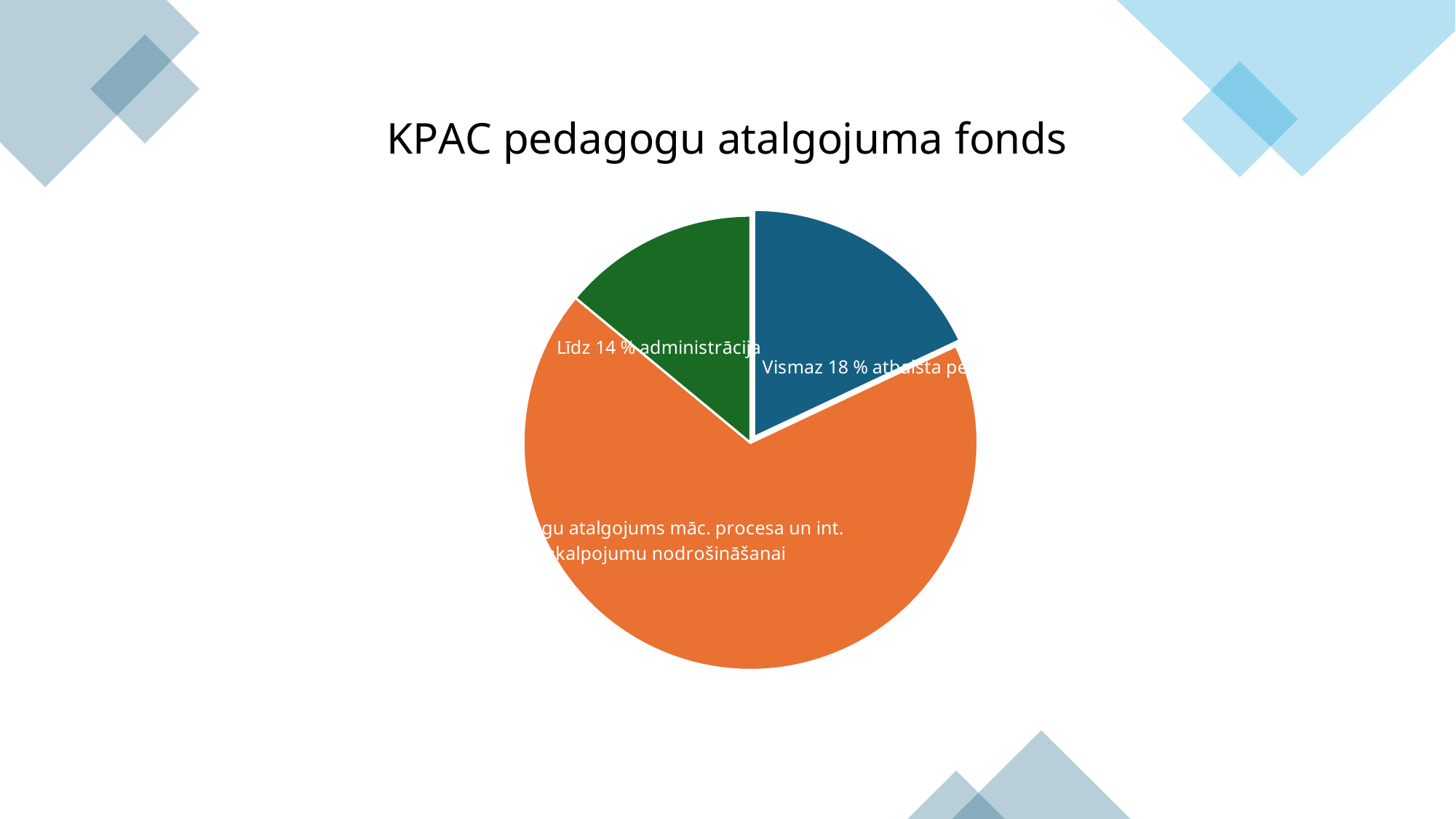
Does the largest slice of the pie take up more or less than half of the pie? more What colour is the slice labelled 'Līdz 14 % administrācija'? green Which is larger: the slice for 'Līdz 14 % administrācija' or the slice for pedagogu atalgojums māc. procesa un int. pakalpojumu nodrošināšanai? Pedagogu atalgojums māc. procesa un int. pakalpojumu nodrošināšanai Which slice of the pie chart is the largest? Pedagogu atalgojums māc. procesa un int. pakalpojumu nodrošināšanai What kind of chart is shown on the slide? pie chart What is the title of the chart? KPAC pedagogu atalgojuma fonds Does the slice labelled 'Līdz 14 % administrācija' take up more or less than half of the pie? less How many slices does the pie chart have? 3